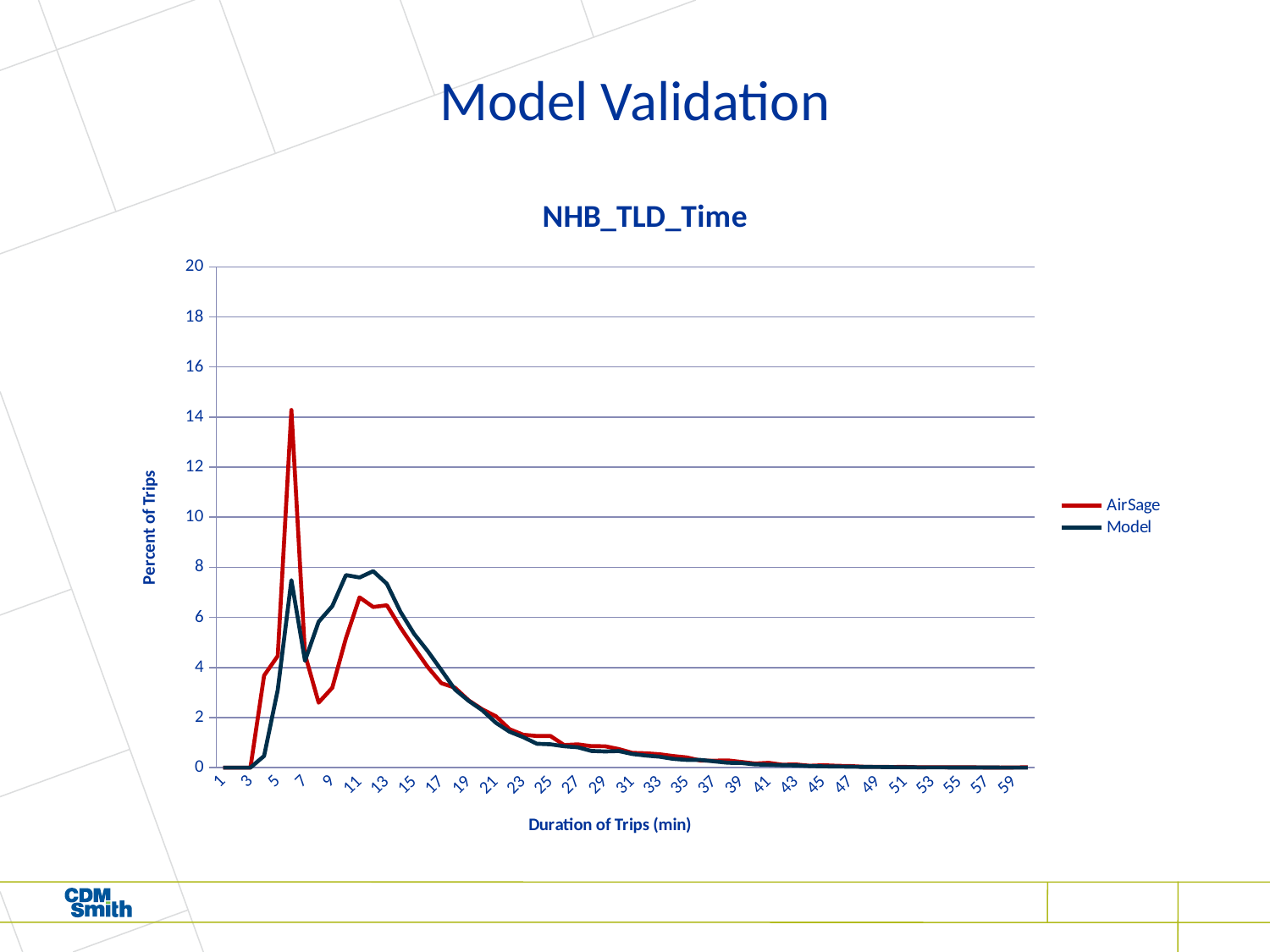
Is the value of the Model series at 12 minutes greater or less than 6? greater Which series reaches the highest peak on the chart? AirSage Is the peak value of the AirSage series greater or less than 12? greater How many series does the legend list? 2 What is the label of the y axis? Percent of Trips At a trip duration of 6 minutes, which series has the larger value, AirSage or Model? AirSage Is the value of the AirSage series at 9 minutes greater or less than 4? less What kind of chart is shown on the slide? line chart Do the values of both series rise or fall as trip duration increases from 15 minutes to 59 minutes? fall At a trip duration of 11 minutes, which series has the larger value, AirSage or Model? Model What is the title of the chart? NHB_TLD_Time